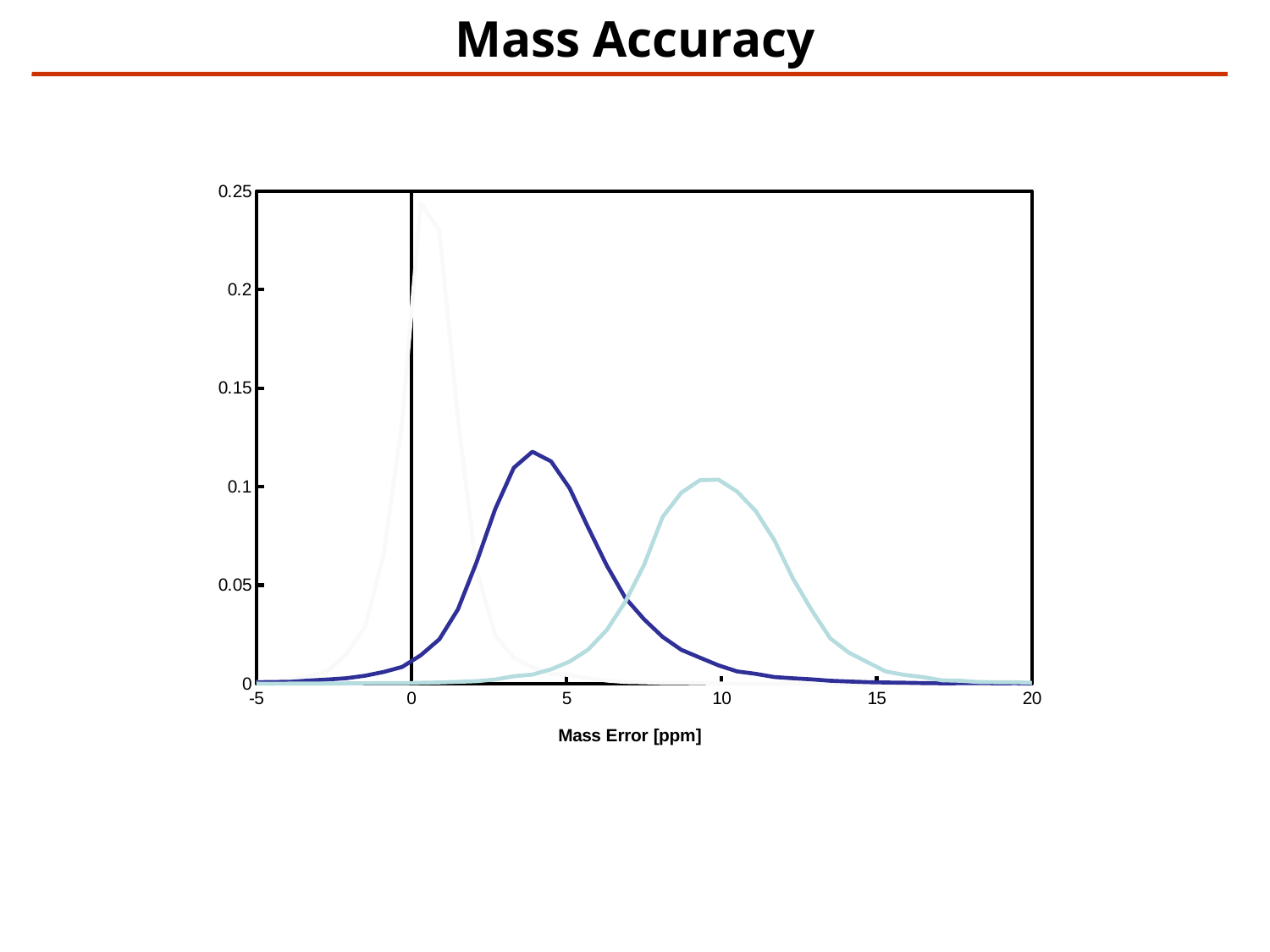
Is the dark blue curve's peak located at a mass error greater or less than 5 ppm? less What is the label of the x axis? Mass Error [ppm] What is the highest value shown on the y axis? 0.25 Is the peak value of the faint light grey curve near 0 ppm greater or less than 0.2? greater Which curve has the higher peak, the faint light grey curve near 0 ppm or the dark blue curve? the faint light grey curve Which curve reaches its peak at the largest mass error, the dark blue curve or the light blue curve? the light blue curve Is the peak value of the dark blue curve greater or less than 0.1? greater What kind of chart is shown on the slide? line chart What is the title of the chart? Mass Accuracy